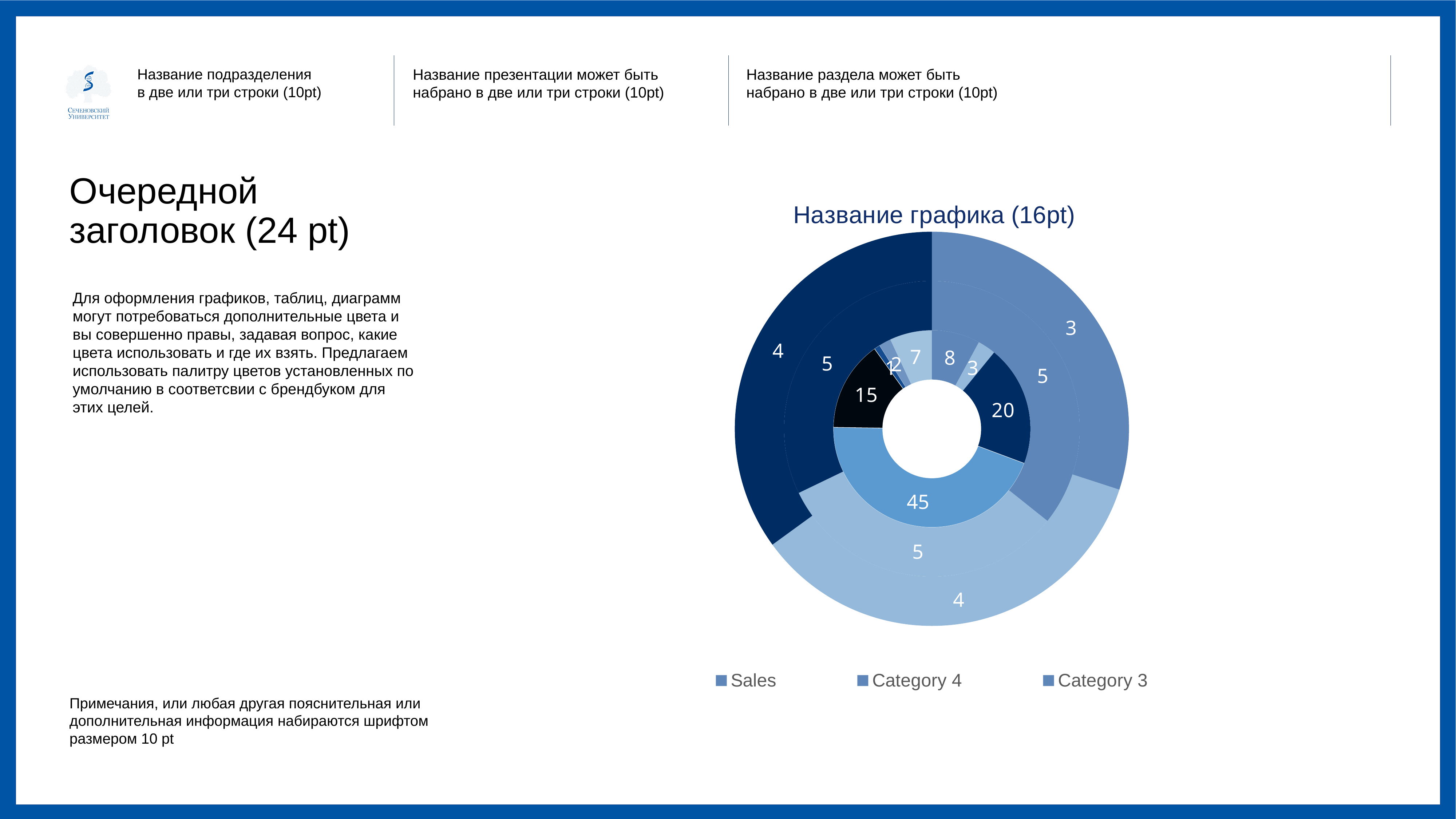
What kind of chart is shown on the slide? doughnut chart In the innermost ring, which is larger: the segment labelled 8 or the segment labelled 7? 8 In the innermost ring, what is the difference between the largest segment (45) and the segment labelled 20? 25 What is the largest data label shown in the innermost ring of the doughnut chart? 45 In the innermost ring, which is larger: the segment labelled 45 or the segment labelled 15? 45 How many series does the chart legend list? 3 What is the smallest data label shown in the innermost ring of the doughnut chart? 1 Which series is listed first in the chart legend? Sales In the innermost ring, what is the difference between the segments labelled 20 and 15? 5 What is the title of the chart? Название графика (16pt)